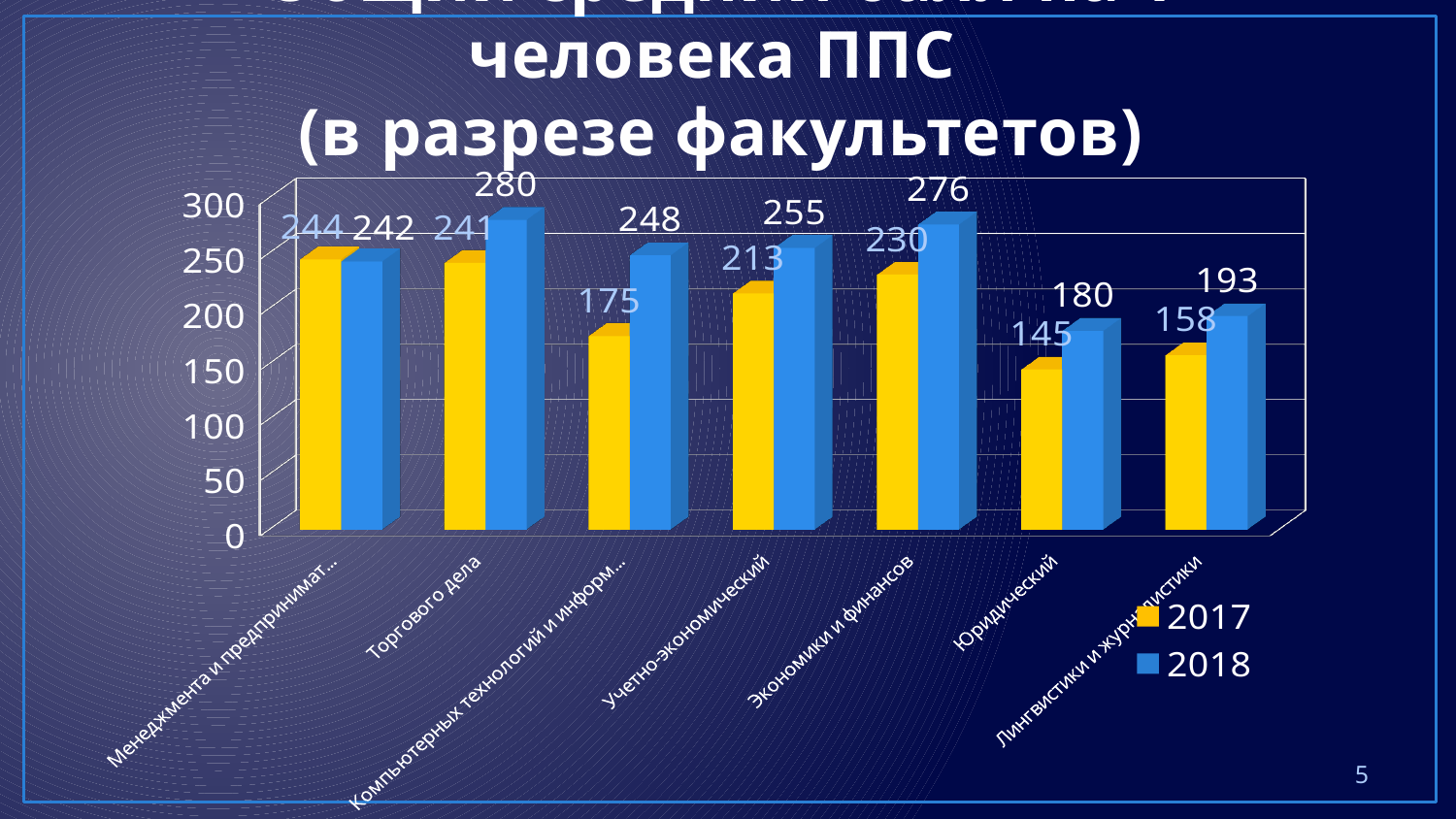
What is the 2017 value for Экономики и финансов? 230 Which is larger for Лингвистики и журналистики, the 2017 value or the 2018 value? 2018 How many series does the legend list? 2 Which faculty has the highest 2018 value? Торгового дела What is the 2018 value for Торгового дела? 280 Which colour represents the 2017 series in the legend? Yellow What is the 2017 value for Юридический? 145 How many faculties are shown on the x axis? 7 What kind of chart is shown on the slide? Bar chart What is the 2018 value for Учетно-экономический? 255 Which faculty has the lowest 2017 value? Юридический What is the difference between the 2018 and 2017 values for Экономики и финансов? 46